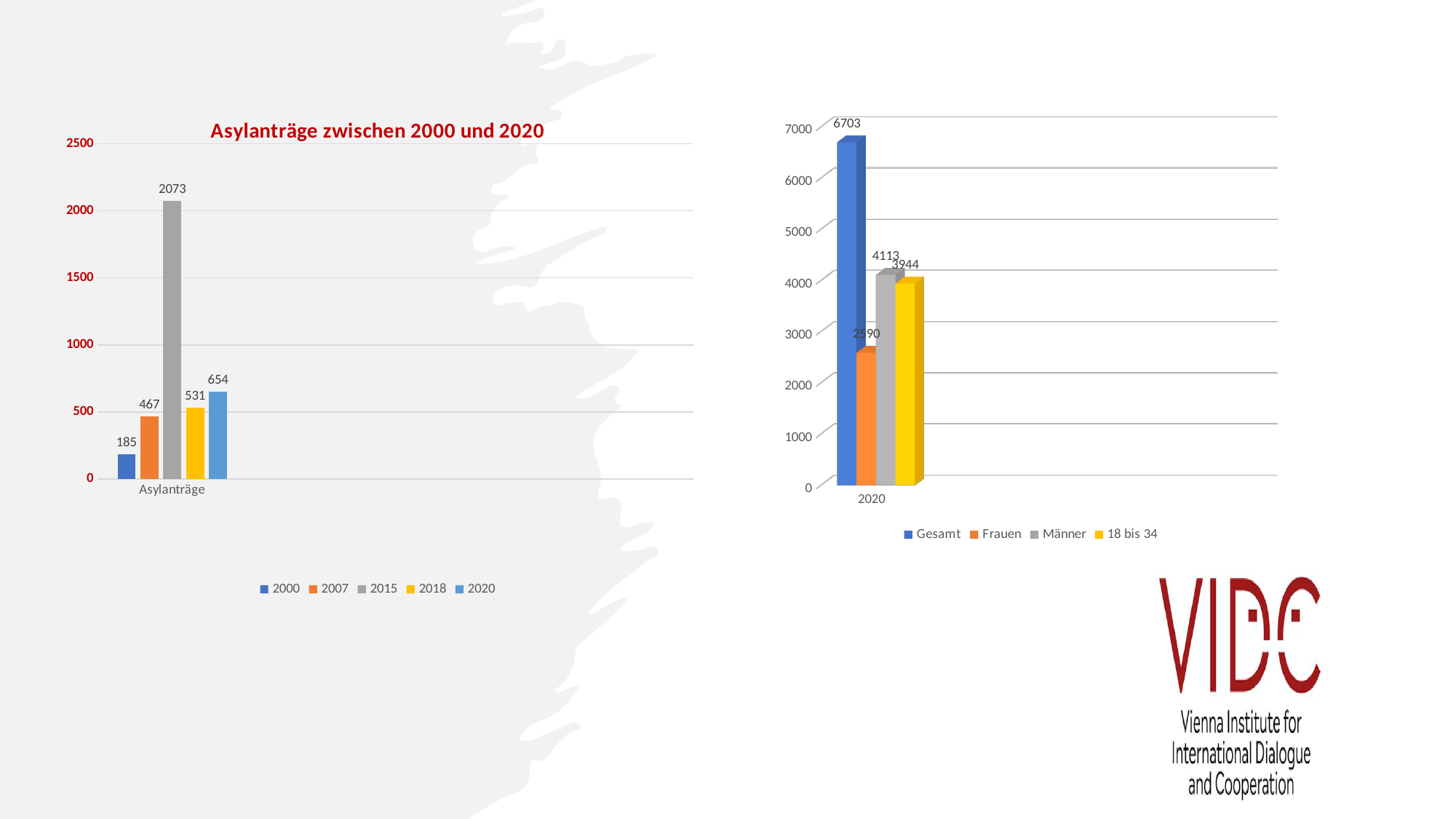
In the chart titled 'Asylanträge zwischen 2000 und 2020', is the value for 2007 greater or less than 500? less In the chart on the right, what is the value for Frauen in 2020? 2590 In the chart titled 'Asylanträge zwischen 2000 und 2020', which year has the highest value? 2015 In the chart on the right, which is larger, Männer or 18 bis 34? Männer What kind of chart is the chart on the right? bar chart In the chart titled 'Asylanträge zwischen 2000 und 2020', which year has the lowest value? 2000 In the chart titled 'Asylanträge zwischen 2000 und 2020', what is the value for 2015? 2073 In the chart titled 'Asylanträge zwischen 2000 und 2020', what is the value for 2000? 185 In the chart on the right, what is the value for Gesamt in 2020? 6703 In the chart titled 'Asylanträge zwischen 2000 und 2020', what is the difference between the values for 2020 and 2018? 123 In the chart on the right, what is the difference between Männer and Frauen? 1523 In the chart titled 'Asylanträge zwischen 2000 und 2020', how many series does the legend list? 5